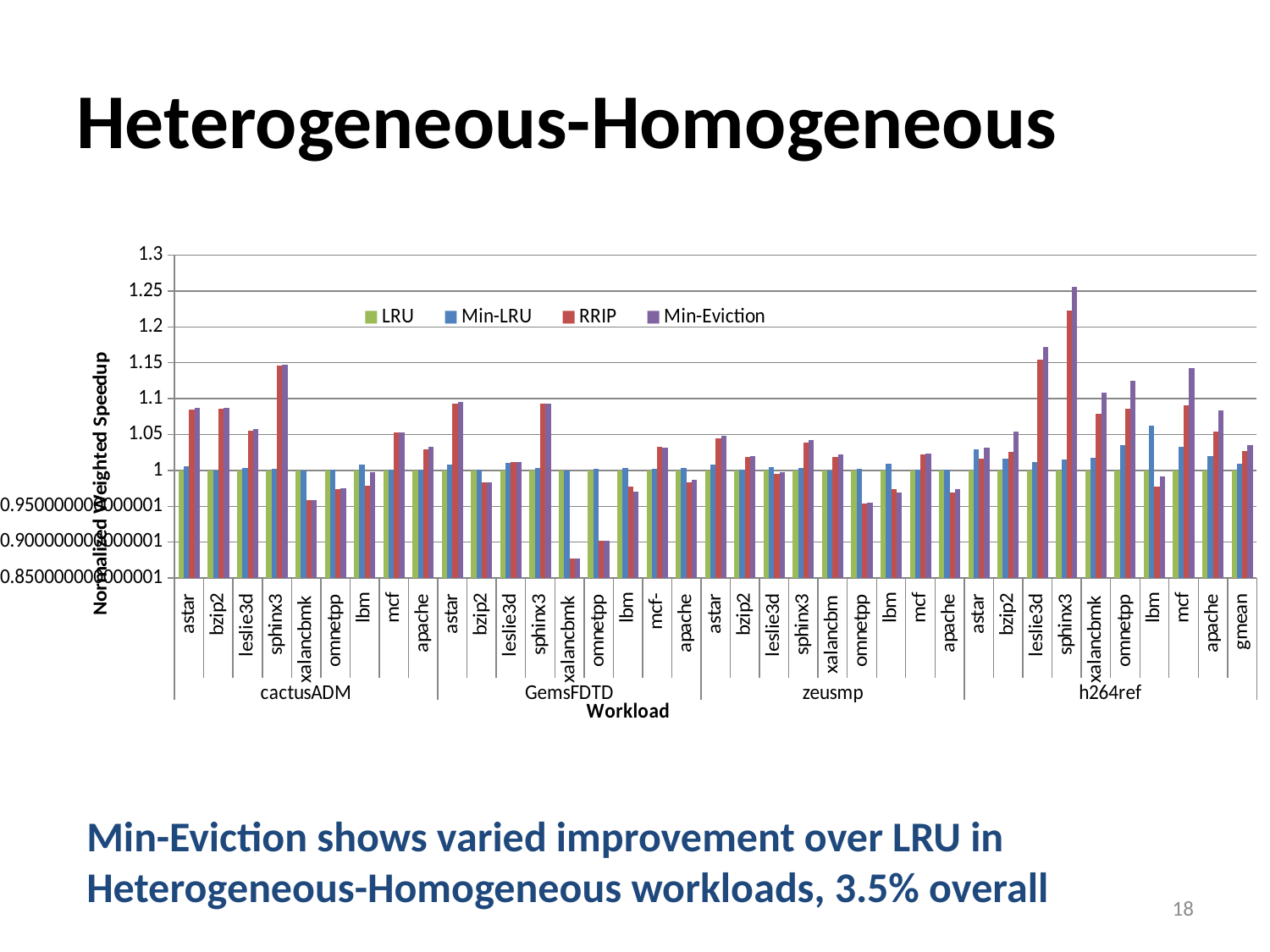
Which bar is the highest in the whole chart? Min-Eviction for sphinx3 in h264ref How many workload groups (cactusADM, GemsFDTD, etc.) are labelled along the x axis, excluding gmean? 4 What is the label of the y axis? Normalized Weighted Speedup Is the Min-Eviction value for sphinx3 in h264ref greater or less than 1.2? greater What kind of chart is shown on the slide? bar chart Which bar is the lowest in the whole chart? RRIP and Min-Eviction for xalancbmk in GemsFDTD (tied) Is the RRIP value for xalancbmk in GemsFDTD greater or less than 0.9? less How many series does the legend list? 4 For sphinx3 in h264ref, which is larger: the RRIP value or the Min-Eviction value? Min-Eviction Is the RRIP value for sphinx3 in cactusADM greater or less than 1.1? greater What value do the LRU bars land on across all workloads? 1 Which series are listed in the legend? LRU, Min-LRU, RRIP, Min-Eviction